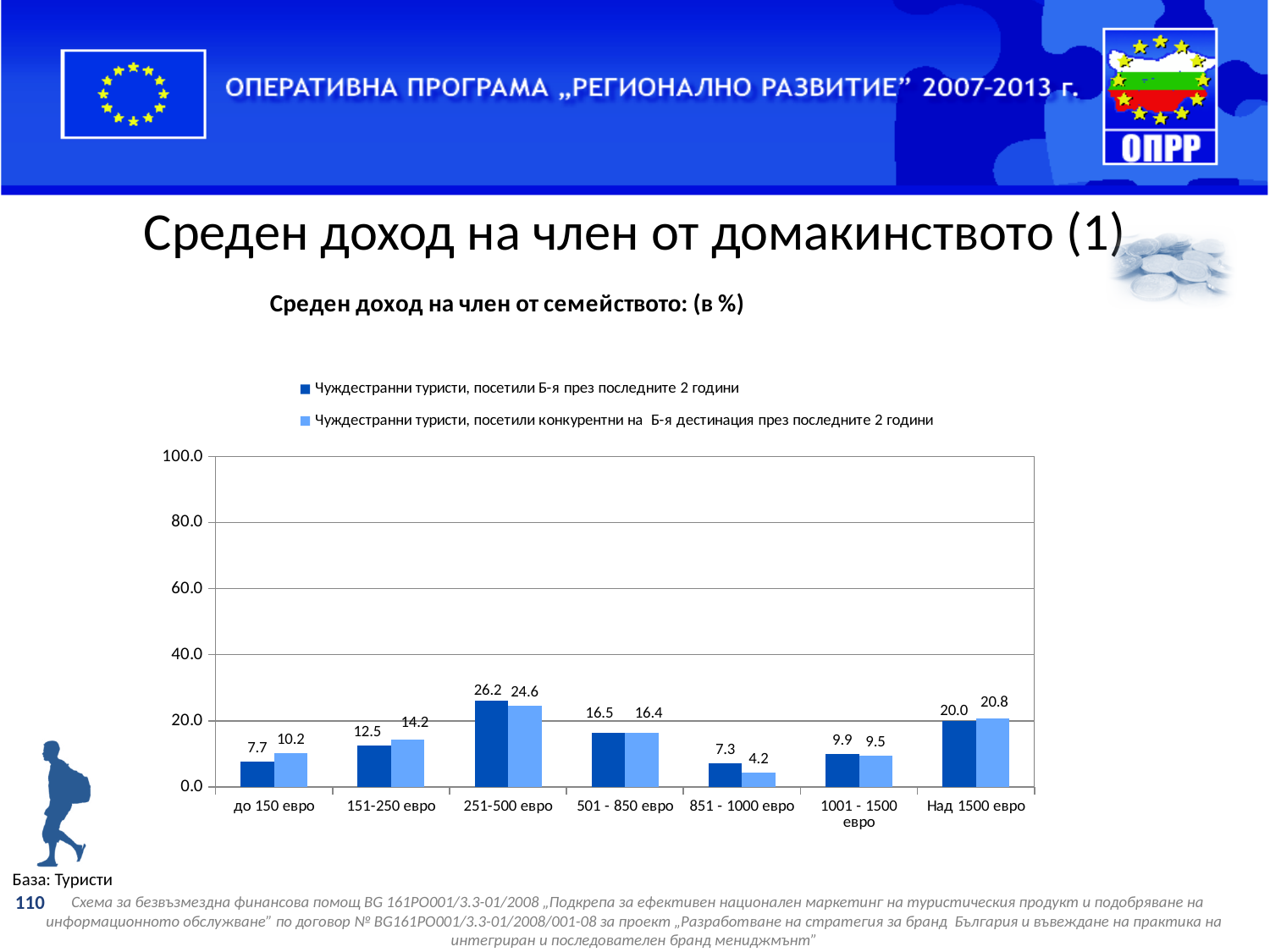
What type of chart is shown on the slide? bar chart What is the title of the chart? Среден доход на член от семейството: (в %) What is the value for "до 150 евро" for the series "Чуждестранни туристи, посетили Б-я през последните 2 години"? 7.7 Which income category has the highest value for the series "Чуждестранни туристи, посетили Б-я през последните 2 години"? 251-500 евро How many series does the chart legend list? 2 For "151-250 евро", which series has the larger value? Чуждестранни туристи, посетили конкурентни на Б-я дестинация през последните 2 години What is the value for "851 - 1000 евро" for the series "Чуждестранни туристи, посетили конкурентни на Б-я дестинация през последните 2 години"? 4.2 How many income categories are shown on the x axis of the chart? 7 What is the value for "Над 1500 евро" for the series "Чуждестранни туристи, посетили конкурентни на Б-я дестинация през последните 2 години"? 20.8 What is the difference between the two series' values for "851 - 1000 евро"? 3.1 Which income category has the lowest value for the series "Чуждестранни туристи, посетили конкурентни на Б-я дестинация през последните 2 години"? 851 - 1000 евро Is the value for "251-500 евро" for the series "Чуждестранни туристи, посетили Б-я през последните 2 години" greater or less than 20.0? greater